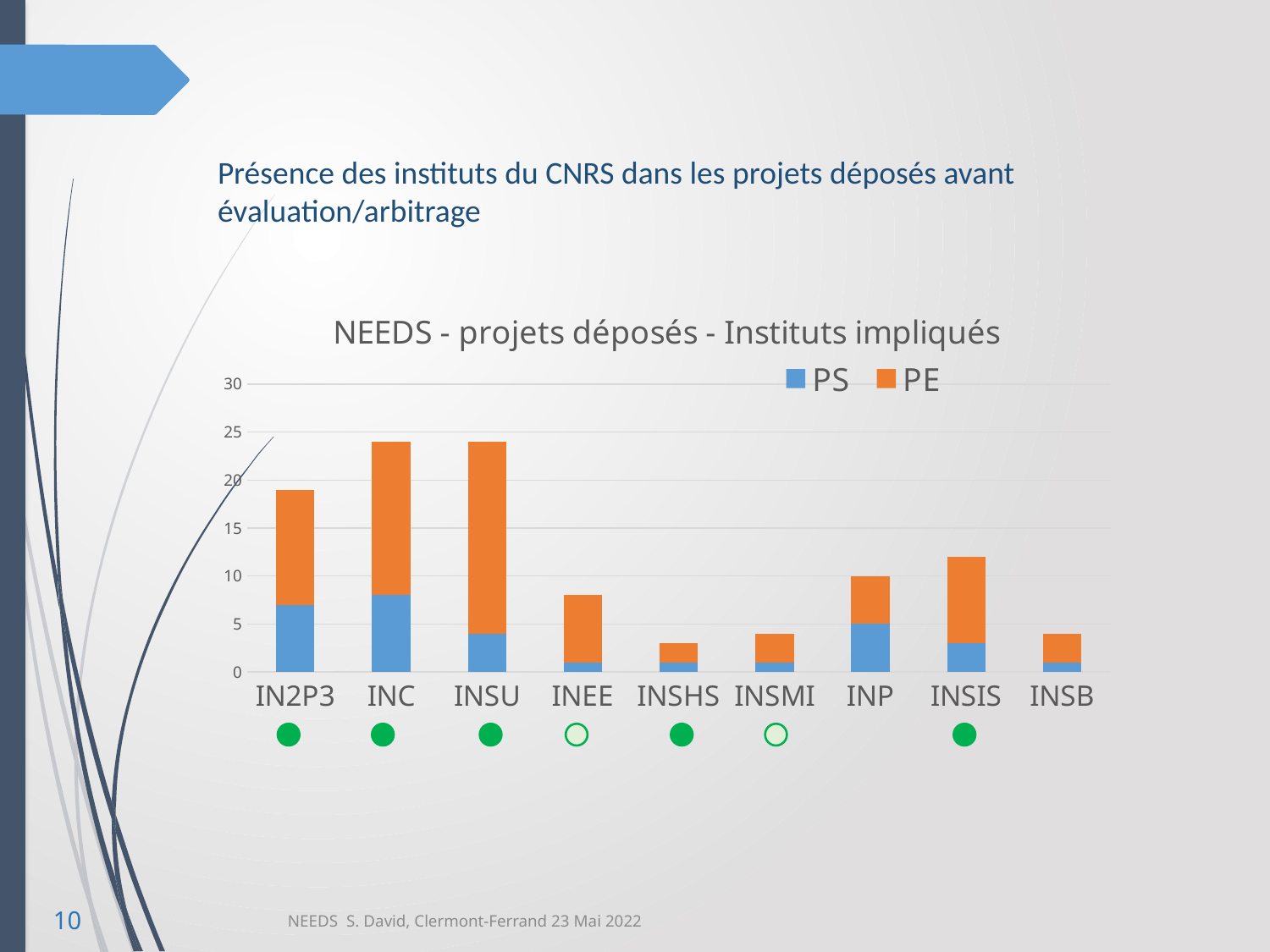
What are the two series named in the chart legend? PS and PE What is the title of the chart? NEEDS - projets déposés - Instituts impliqués Is the total bar height for INEE greater or less than 10? less Is the total bar height for INSHS greater or less than 5? less Is the total bar height for IN2P3 greater or less than 15? greater How many institutes (categories) are shown on the x axis of the chart? 9 How many series does the chart legend list? 2 Which has the taller total bar, INSIS or INEE? INSIS Which has the taller total bar, IN2P3 or INP? IN2P3 What kind of chart is shown on the slide? Stacked bar chart